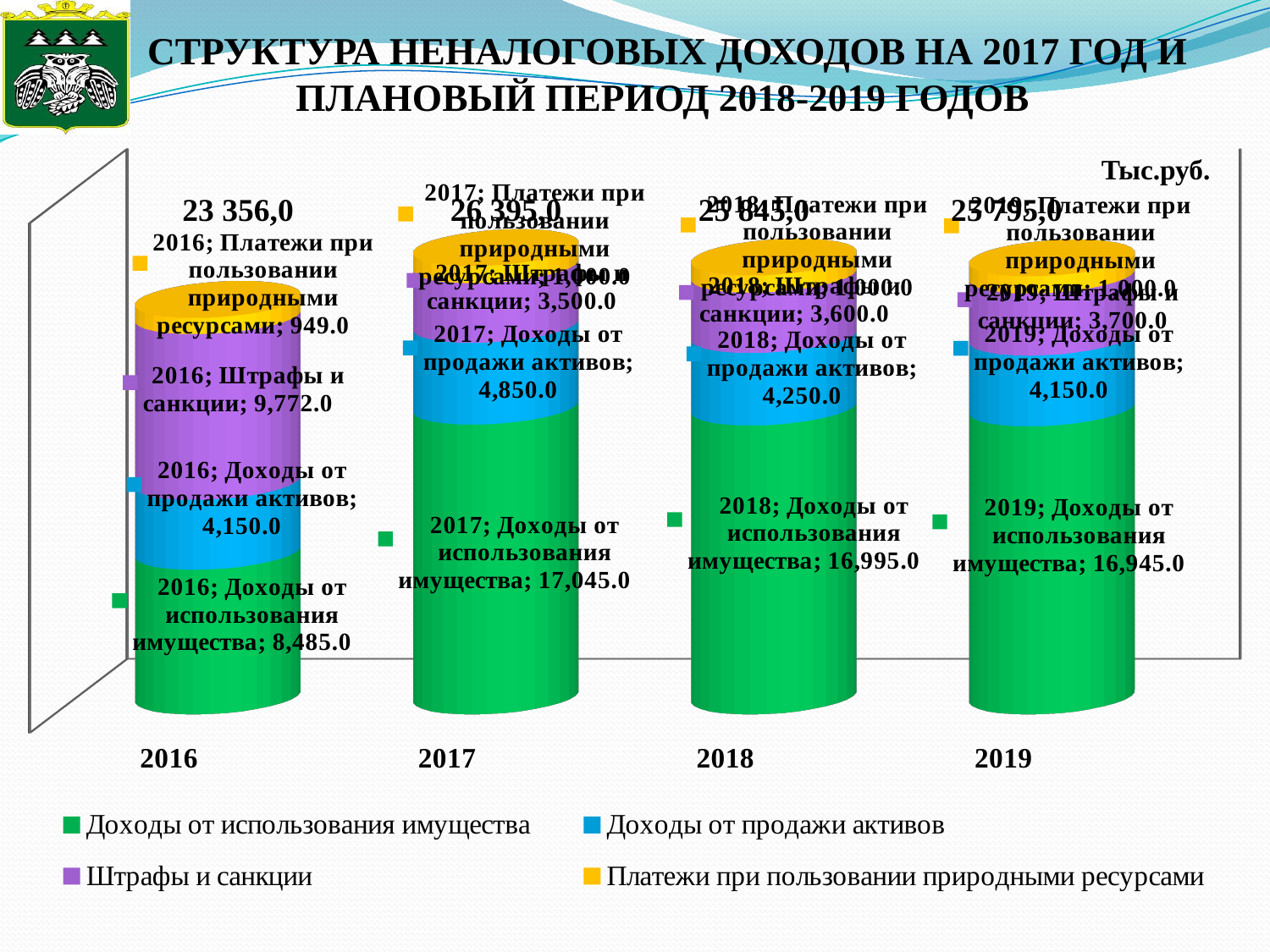
By how much does Доходы от использования имущества in 2017 exceed that in 2016? 8,560.0 Which year has the highest total of non-tax revenues? 2017 How many series does the legend list? 4 What is the total shown above the 2017 bar? 26 395,0 What is the value of Штрафы и санкции for 2016? 9,772.0 What is the value of Доходы от продажи активов for 2018? 4,250.0 How many years are shown on the x axis? 4 Which year has the lowest total of non-tax revenues? 2016 What kind of chart is shown on the slide? Stacked bar chart In 2016, which is larger: Штрафы и санкции or Доходы от использования имущества? Штрафы и санкции What is the value of Доходы от использования имущества for 2017? 17,045.0 What is the value of Доходы от использования имущества for 2016? 8,485.0